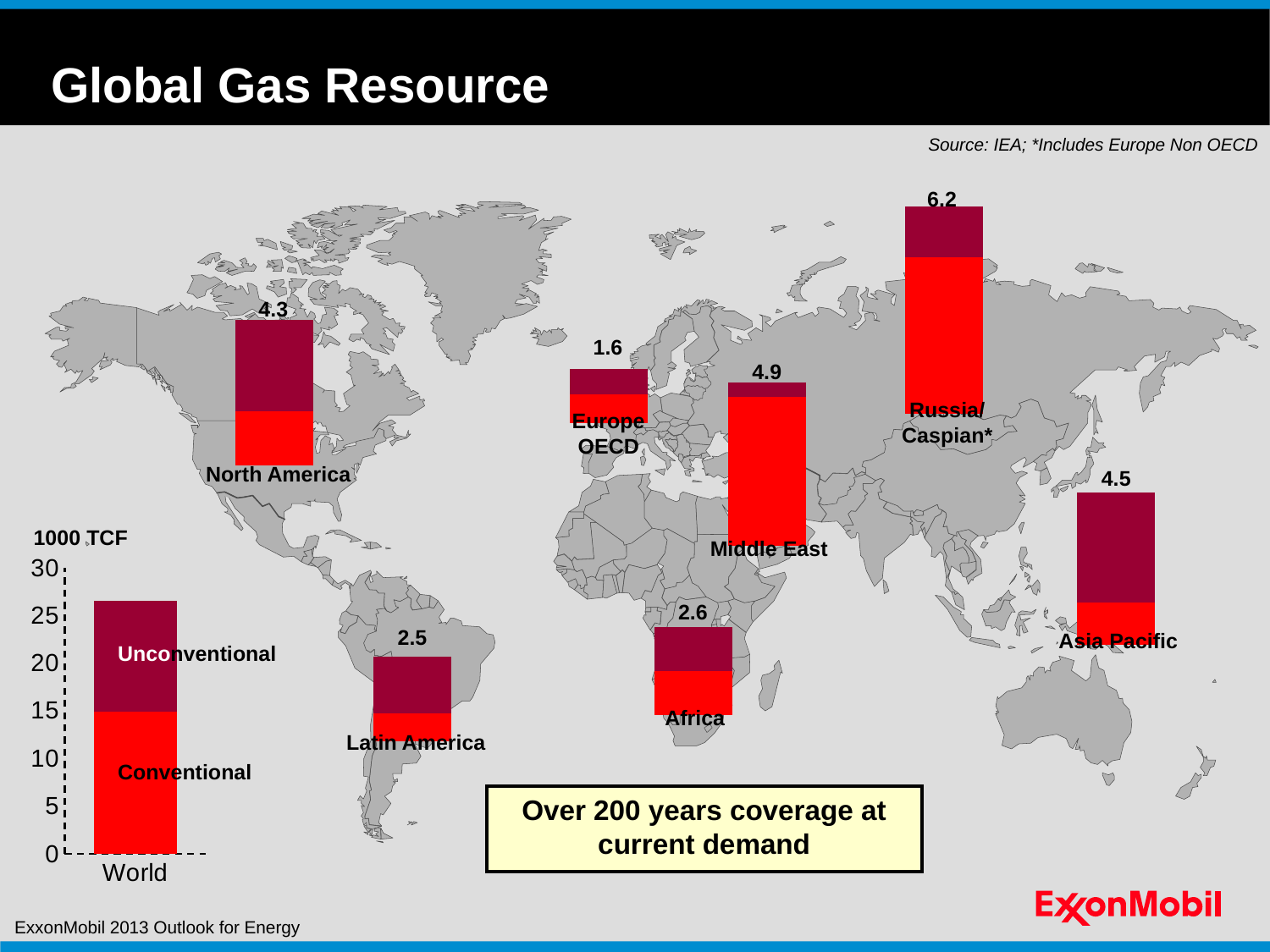
What value is shown for Europe OECD? 1.6 On the World bar, is the Conventional portion greater or less than 10? greater What value is labelled above the Middle East bar? 4.9 Which region has the highest labelled gas resource value? Russia/Caspian* Which region has the lowest labelled gas resource value? Europe OECD What kind of chart is used to show the gas resource values? Stacked bar chart Which has the larger labelled value, Africa or Latin America? Africa How many regional bars are placed on the map (excluding the World bar)? 7 Which has the larger labelled value, Asia Pacific or North America? Asia Pacific What is the total gas resource value shown for Russia/Caspian*? 6.2 What unit is shown on the axis of the World bar chart? 1000 TCF What is the difference between the values for Russia/Caspian* and Europe OECD? 4.6